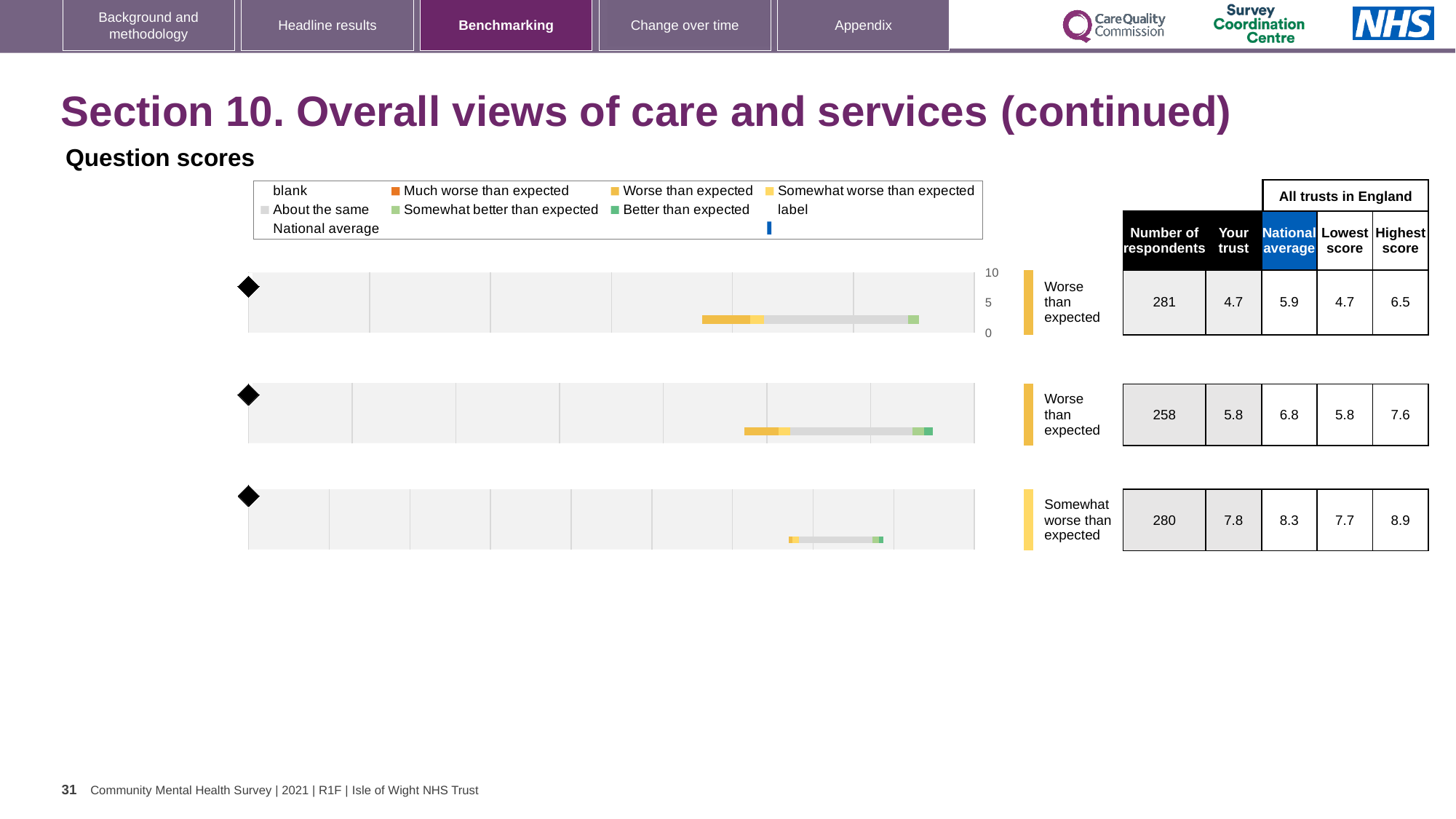
For the top chart, what is the national average score shown in the table? 5.9 How many charts are shown on the slide? 3 For the bottom chart, what is the 'Your trust' score shown in the table? 7.8 For the middle chart, how many respondents are shown in the table? 258 Which chart has the highest 'Your trust' score in the table? The bottom chart What rating label is shown next to the bottom chart? Somewhat worse than expected For the bottom chart, what is the highest score among all trusts in England? 8.9 What rating label is shown next to the top chart? Worse than expected What kind of chart is the top chart on the slide? bar chart For the middle chart, what is the difference between the national average and the 'Your trust' score? 1.0 For the top chart, which is larger: the 'Your trust' score or the national average? National average For the top chart, what is the 'Your trust' score shown in the table? 4.7